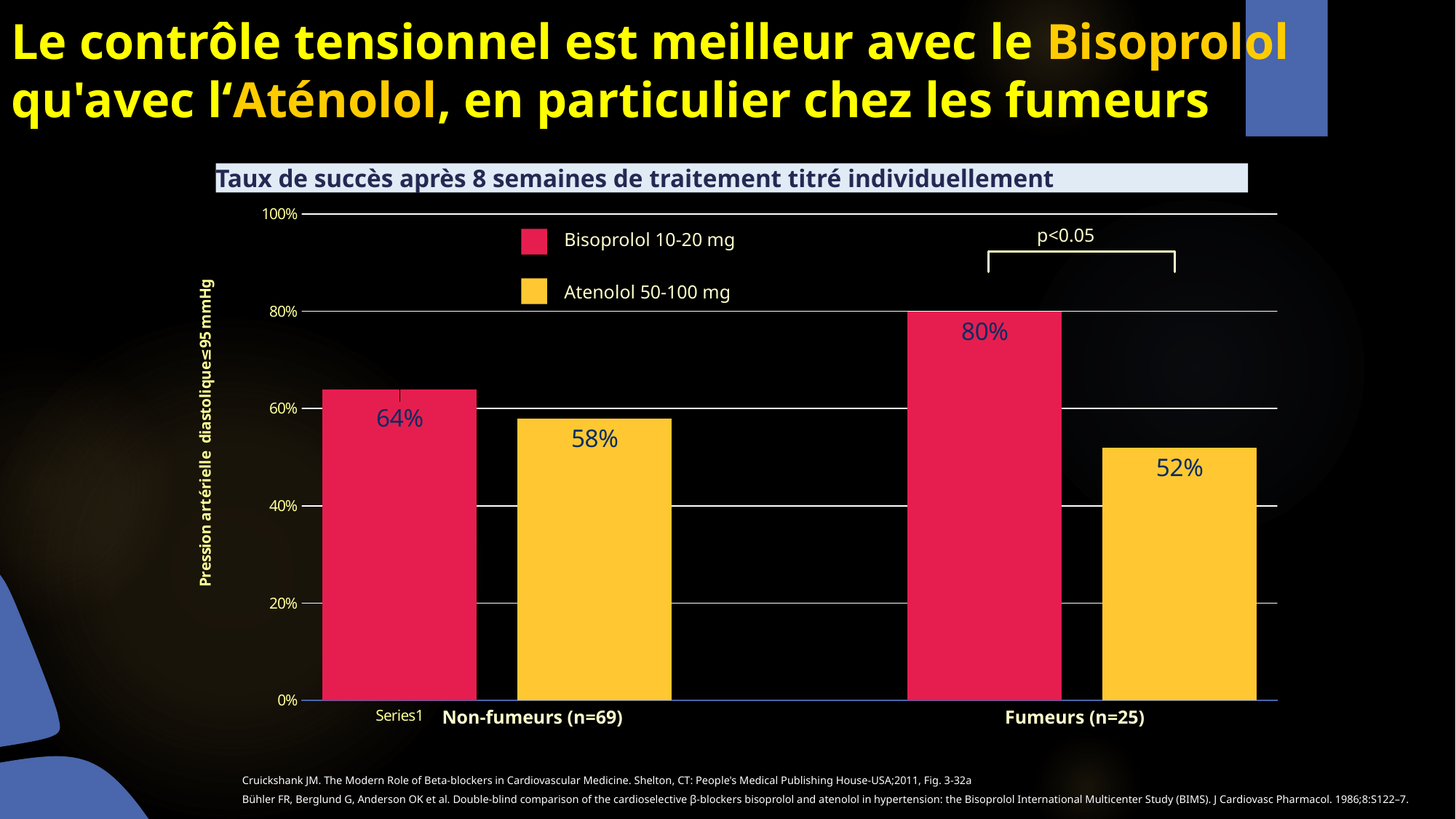
Which group and treatment has the highest success rate? Bisoprolol 10-20 mg, Fumeurs (n=25) What kind of chart is shown on the slide? Bar chart Which is larger: the Bisoprolol success rate among non-smokers or the Atenolol success rate among smokers? Bisoprolol among non-smokers How many series does the legend list? 2 What is the success rate for Atenolol 50-100 mg among smokers (Fumeurs)? 52% What is the success rate for Bisoprolol 10-20 mg among non-smokers (Non-fumeurs)? 64% What is the success rate for Atenolol 50-100 mg among non-smokers (Non-fumeurs)? 58% How many patient groups are shown on the x axis? 2 What is the difference between the Bisoprolol and Atenolol success rates among non-smokers (Non-fumeurs)? 6% What p-value is shown above the smokers (Fumeurs) bars? p<0.05 Which group and treatment has the lowest success rate? Atenolol 50-100 mg, Fumeurs (n=25) What is the difference between the Bisoprolol and Atenolol success rates among smokers (Fumeurs)? 28%